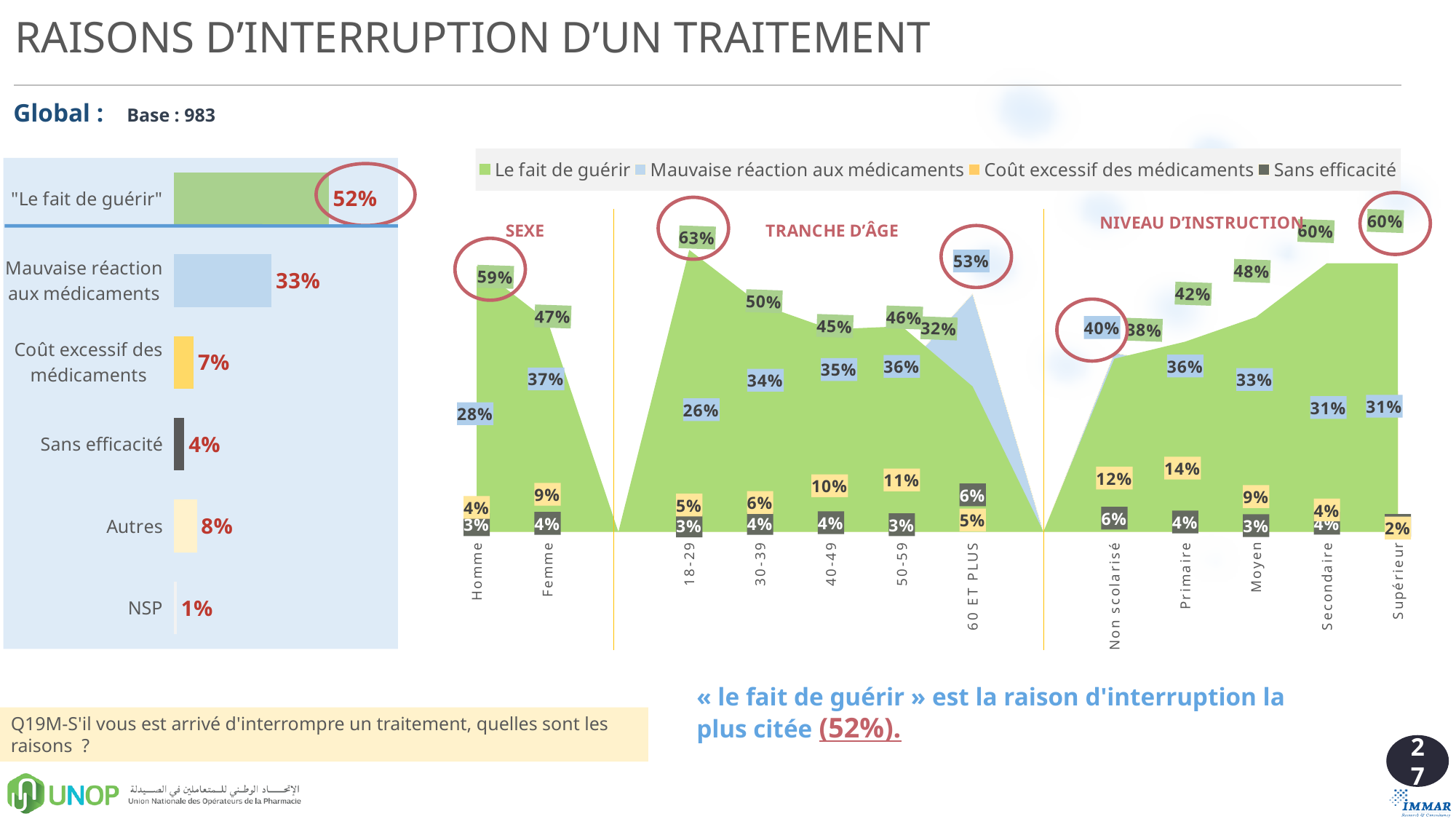
In the right chart, what is the value of "Coût excessif des médicaments" for Primaire? 14% In the left bar chart, what is the difference between "Le fait de guérir" and "Mauvaise réaction aux médicaments"? 19% In the right chart, what is the value of "Mauvaise réaction aux médicaments" for 60 ET PLUS? 53% In the left bar chart, which category has the lowest value? NSP In the right chart, which is larger for Homme: "Le fait de guérir" or "Mauvaise réaction aux médicaments"? Le fait de guérir In the left bar chart, what is the value for "Le fait de guérir"? 52% In the left bar chart, how many categories are shown? 6 In the right chart, what is the difference between "Le fait de guérir" for Homme and for Femme? 12% What kind of chart is the chart on the left of the slide? Bar chart In the right chart, how many series does the legend list? 4 In the right chart, what is the value of "Le fait de guérir" for 18-29? 63% In the left bar chart, what is the value for "Mauvaise réaction aux médicaments"? 33%